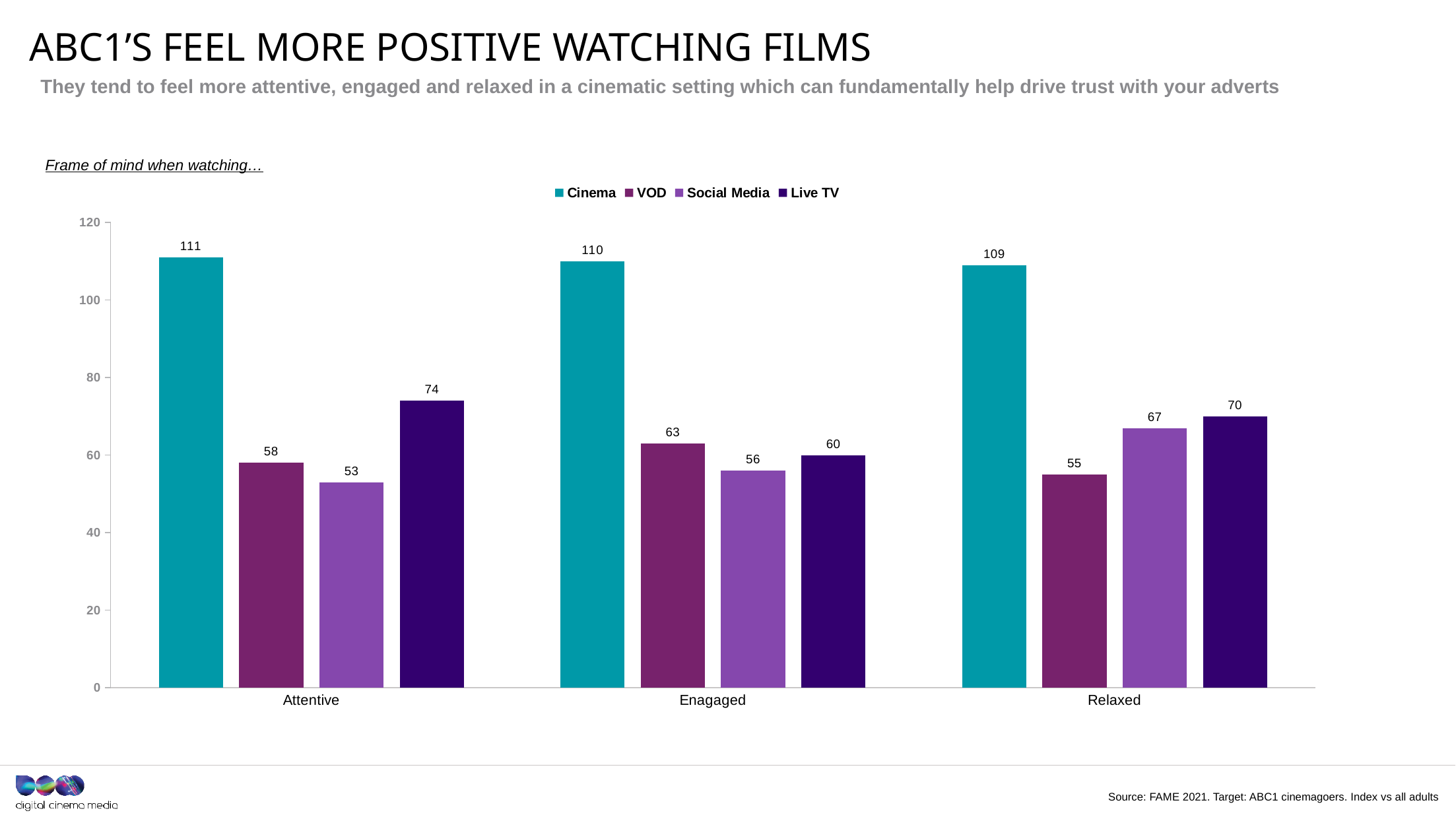
What is the difference between the Cinema and Live TV values for Attentive? 37 What is the Cinema value for Attentive? 111 What is the Social Media value for Relaxed? 67 Which is larger for Enagaged: VOD or Social Media? VOD How many categories are shown on the x axis? 3 How many series does the legend list? 4 Which series has the lowest value for Attentive? Social Media What is the Live TV value for Enagaged? 60 Do the Cinema values rise or fall from Attentive to Relaxed? Fall What kind of chart is shown on the slide? Bar chart Which series has the highest value for Relaxed? Cinema Is the Live TV value for Relaxed greater or less than 60? greater